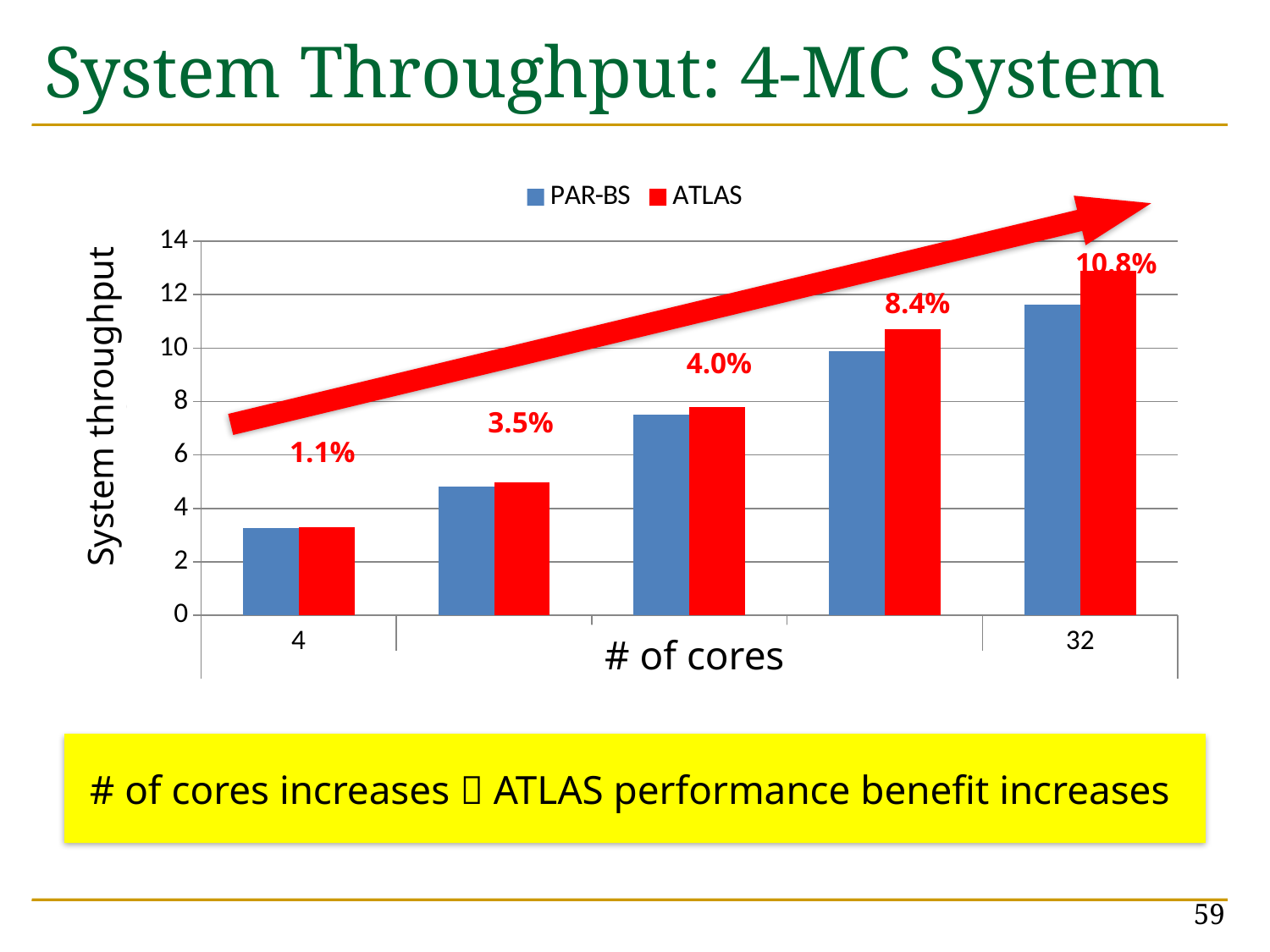
At 32 cores, which is larger: the PAR-BS bar or the ATLAS bar? ATLAS Is the ATLAS system throughput at 32 cores greater or less than 12? greater How many series does the legend list? 2 How many groups of bars (core counts) are plotted on the x axis? 5 What is the percentage improvement label shown above the bars for 4 cores? 1.1% What kind of chart is shown on the slide? bar chart Which core count has the highest ATLAS system throughput? 32 What are the two series named in the legend? PAR-BS and ATLAS What is the percentage improvement label shown above the bars for 32 cores? 10.8% Is the PAR-BS system throughput at 4 cores greater or less than 4? less Do the system throughput values rise or fall as the number of cores increases along the x axis? rise Which core count has the lowest PAR-BS system throughput? 4